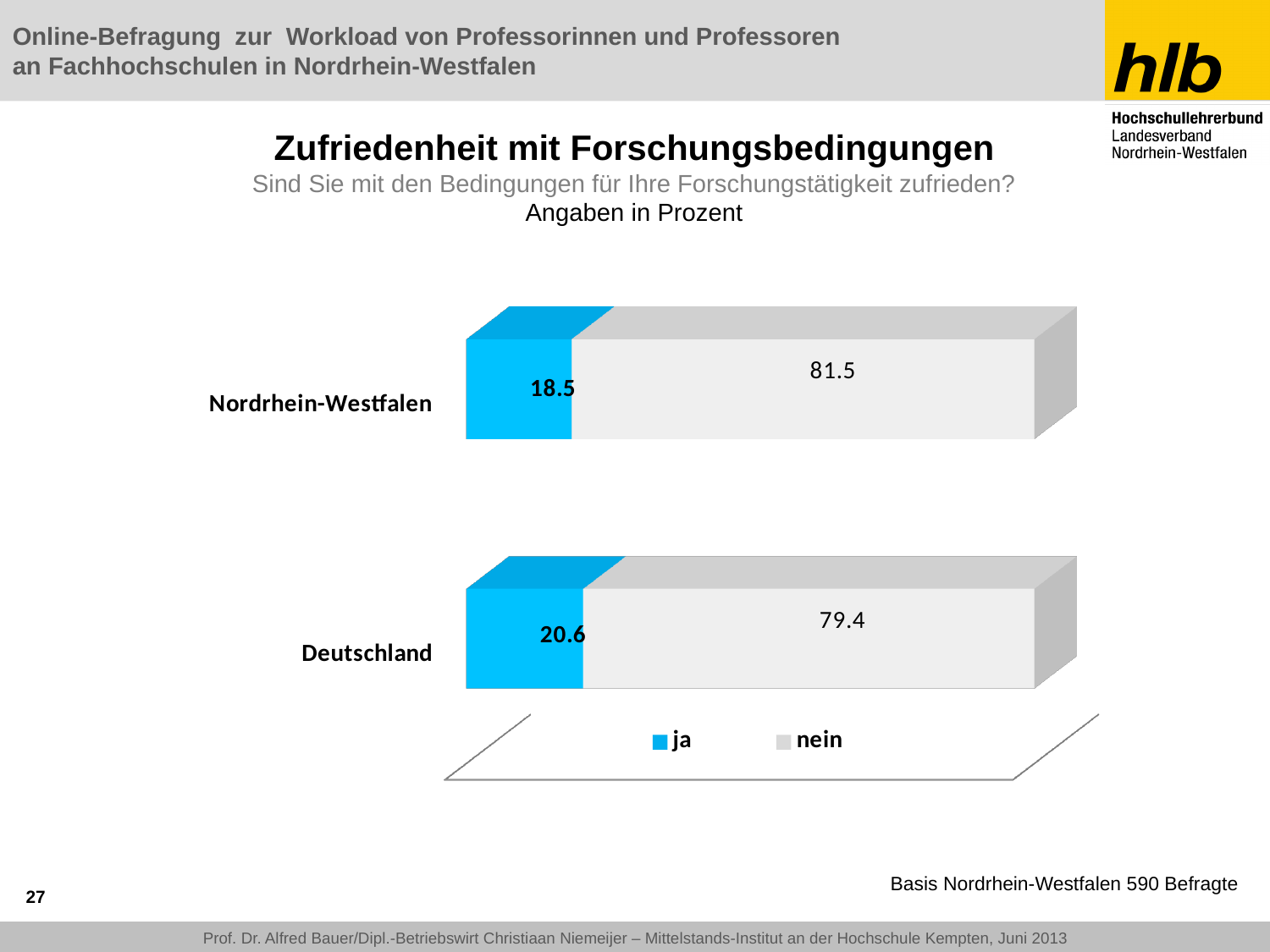
What is the 'ja' value for Nordrhein-Westfalen? 18.5 What is the difference between the 'nein' and 'ja' values for Nordrhein-Westfalen? 63 How many series does the legend list? 2 What kind of chart is shown on the slide? Stacked bar chart What is the 'nein' value for Nordrhein-Westfalen? 81.5 What is the 'ja' value for Deutschland? 20.6 Which category has the higher 'ja' value, Nordrhein-Westfalen or Deutschland? Deutschland What is the total of the stacked bar for Deutschland? 100 Which category has the highest 'nein' value? Nordrhein-Westfalen What is the 'nein' value for Deutschland? 79.4 What is the difference between the 'ja' values for Deutschland and Nordrhein-Westfalen? 2.1 How many categories are shown in the chart? 2